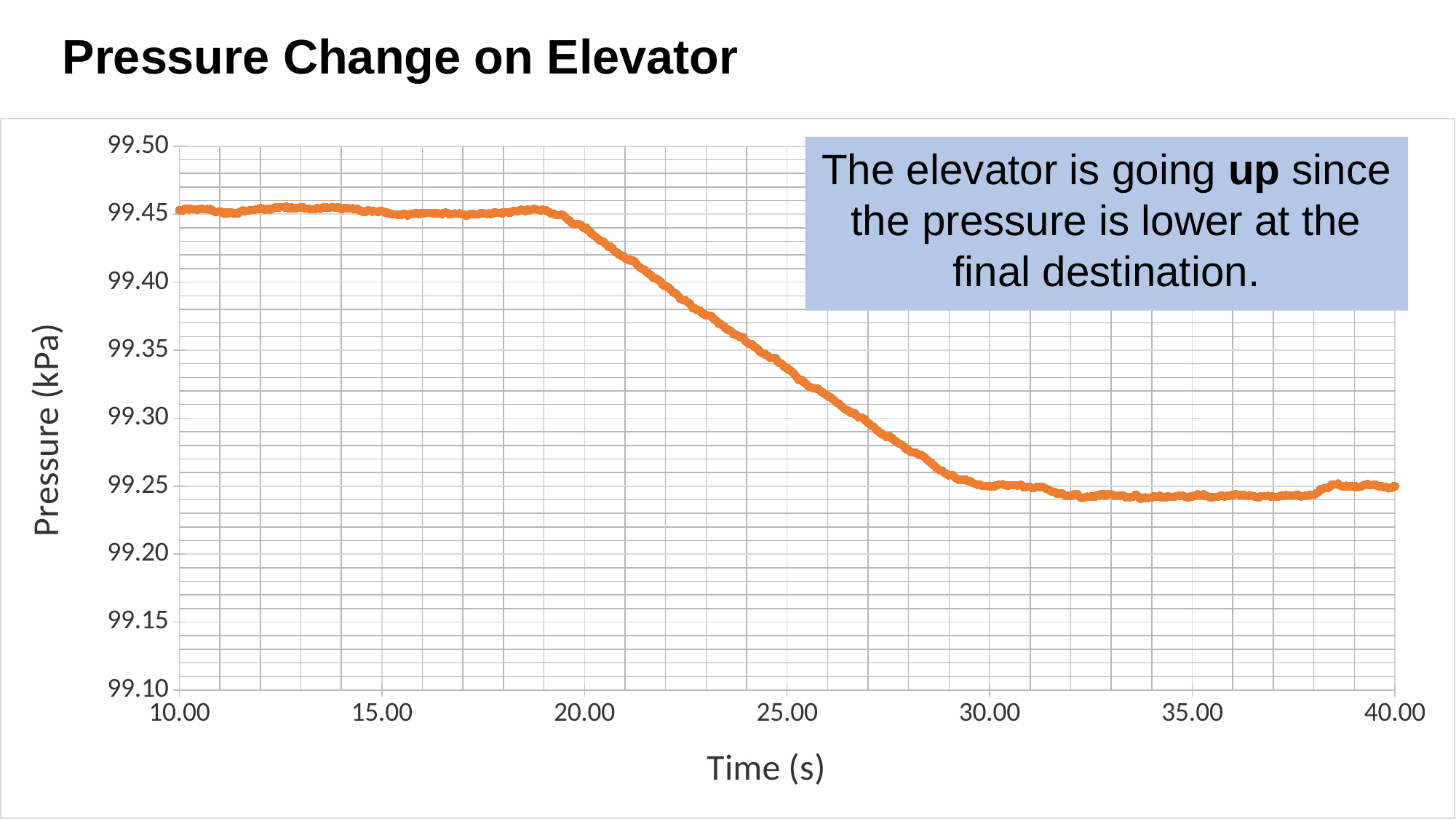
Which is lower, the pressure at 20.00 s or the pressure at 30.00 s? 30.00 s What is the title of the chart? Pressure Change on Elevator Is the pressure at 15.00 s greater or less than 99.40 kPa? greater Is the pressure at 35.00 s greater or less than 99.30 kPa? less Is the pressure at 40.00 s greater or less than 99.20 kPa? greater Overall, does the pressure rise or fall as time increases from 10.00 s to 40.00 s? fall What kind of chart is shown on the slide? line chart Which is higher, the pressure at 15.00 s or the pressure at 35.00 s? 15.00 s Is the pressure higher at the start of the plotted time range (10.00 s) or at the end (40.00 s)? at the start (10.00 s) What is the label of the y axis? Pressure (kPa)